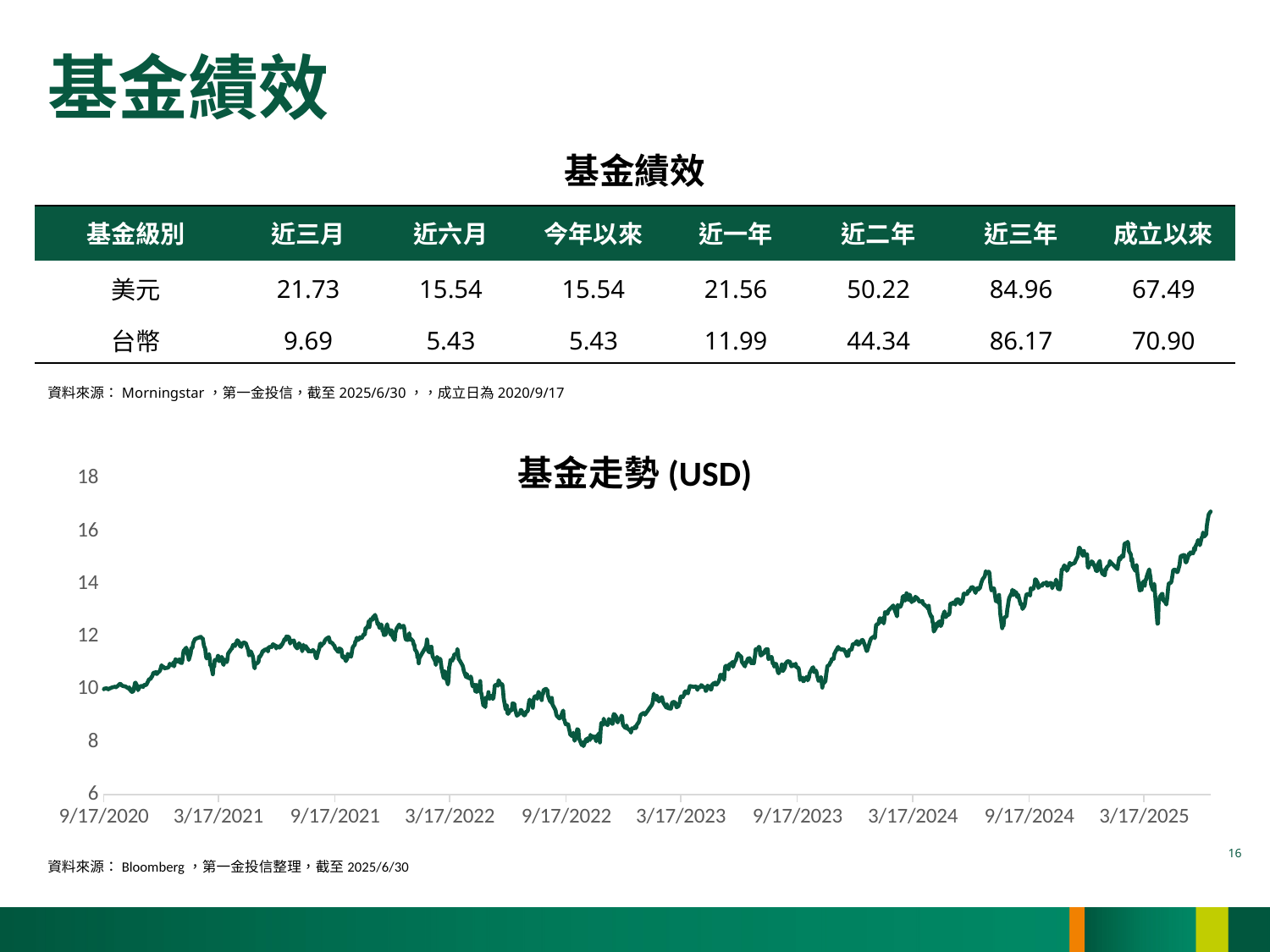
In the 基金走勢 (USD) chart, is the value at 3/17/2024 greater or less than 12? greater In the 基金走勢 (USD) chart, is the value at 9/17/2022 greater or less than 10? less In the 基金走勢 (USD) chart, is the final value at the right end of the line greater or less than 16? greater In the 基金走勢 (USD) chart, does the line overall rise or fall from 9/17/2020 to the end of the series? rise What is the title of the chart on the slide? 基金走勢 (USD) What kind of chart is the 基金走勢 (USD) chart? line chart What is the highest value shown on the y axis of the 基金走勢 (USD) chart? 18 How many date labels are shown on the x axis of the 基金走勢 (USD) chart? 10 In the 基金走勢 (USD) chart, which is larger: the value at 9/17/2022 or the value at 9/17/2024? 9/17/2024